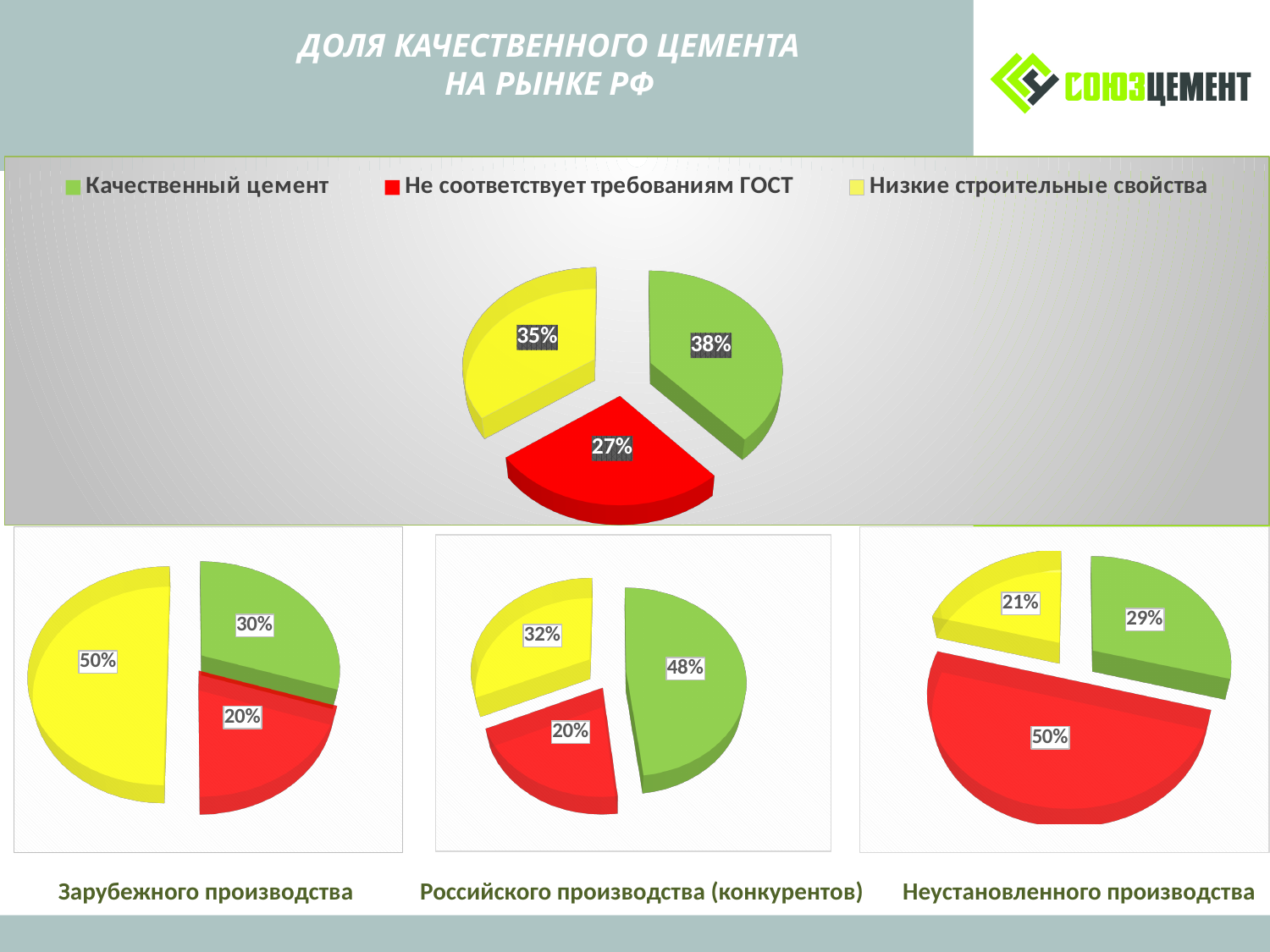
How many categories does the legend at the top of the slide list? 3 In the top pie chart, what is the difference between the 'Качественный цемент' share and the 'Низкие строительные свойства' share? 3% In the 'Российского производства (конкурентов)' pie chart, what share is labelled for 'Качественный цемент' (green)? 48% In the top pie chart, which category has the smallest share? Не соответствует требованиям ГОСТ In the 'Зарубежного производства' pie chart, which category has the largest share? Низкие строительные свойства In the 'Неустановленного производства' pie chart, what share is labelled for 'Не соответствует требованиям ГОСТ' (red)? 50% In the 'Неустановленного производства' pie chart, which category has the smallest share? Низкие строительные свойства In the top pie chart, what share is labelled for 'Качественный цемент' (green)? 38% What type of chart is used for the 'Зарубежного производства' chart? Pie chart In the top pie chart, what share is labelled for 'Не соответствует требованиям ГОСТ' (red)? 27% In the 'Российского производства (конкурентов)' pie chart, which is larger: the 'Низкие строительные свойства' share or the 'Не соответствует требованиям ГОСТ' share? Низкие строительные свойства In the 'Зарубежного производства' pie chart, what share is labelled for 'Низкие строительные свойства' (yellow)? 50%